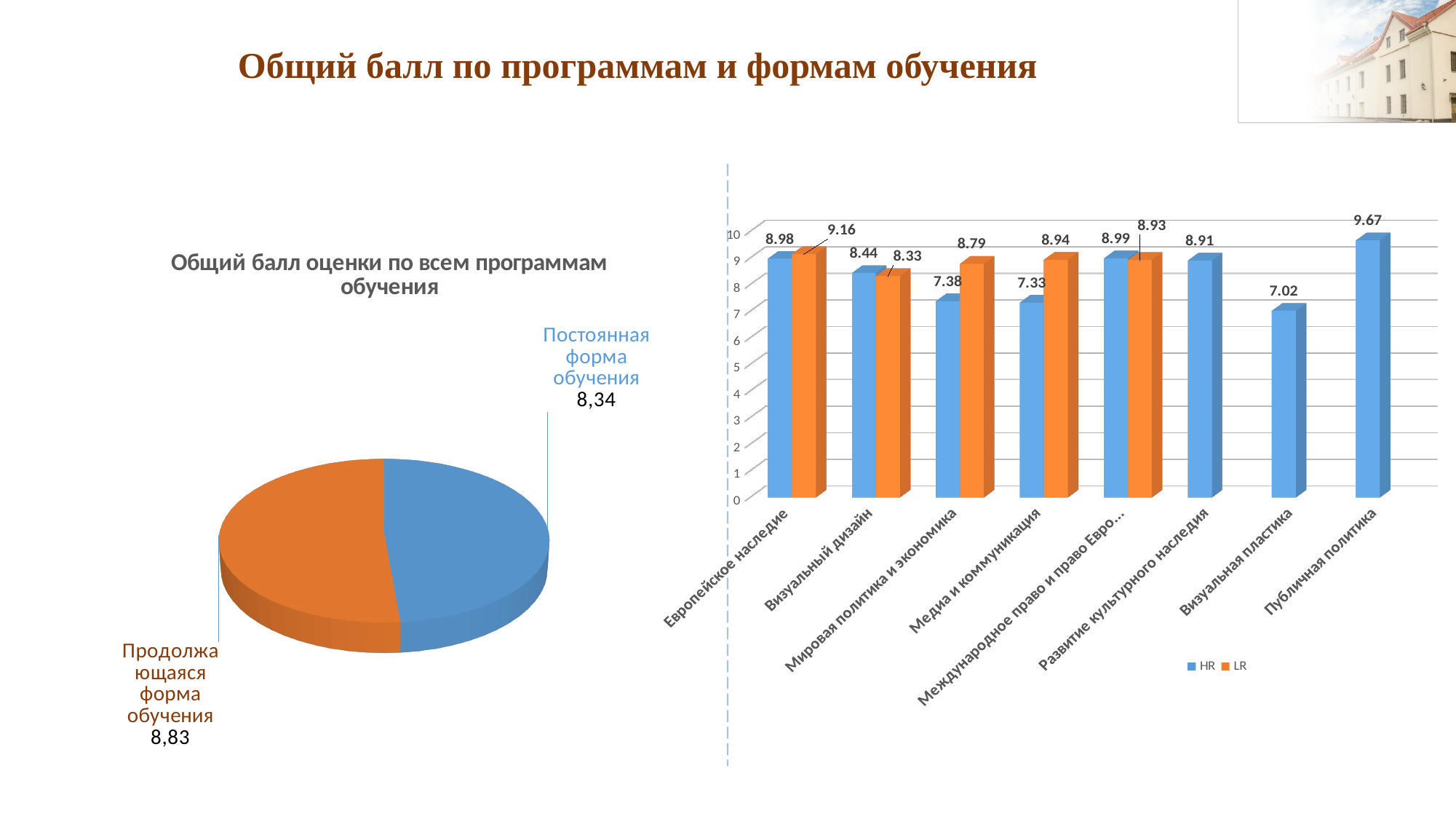
In the bar chart on the right, which is larger for Визуальный дизайн: the HR value or the LR value? HR In the bar chart on the right, how many categories are shown on the x axis? 8 In the bar chart on the right, what is the LR value for Европейское наследие? 9.16 In the pie chart on the left, which form of study has the higher value? Продолжающаяся форма обучения In the pie chart on the left, what is the value for Постоянная форма обучения? 8,34 In the bar chart on the right, what is the HR value for Медиа и коммуникация? 7.33 In the bar chart on the right, what is the difference between the LR and HR values for Мировая политика и экономика? 1.41 In the bar chart on the right, how many series does the legend list? 2 In the bar chart on the right, which category has the lowest HR value? Визуальная пластика In the bar chart on the right, which category has the highest HR value? Публичная политика What type of chart is shown on the left side of the slide? Pie chart In the bar chart on the right, what is the HR value for Публичная политика? 9.67